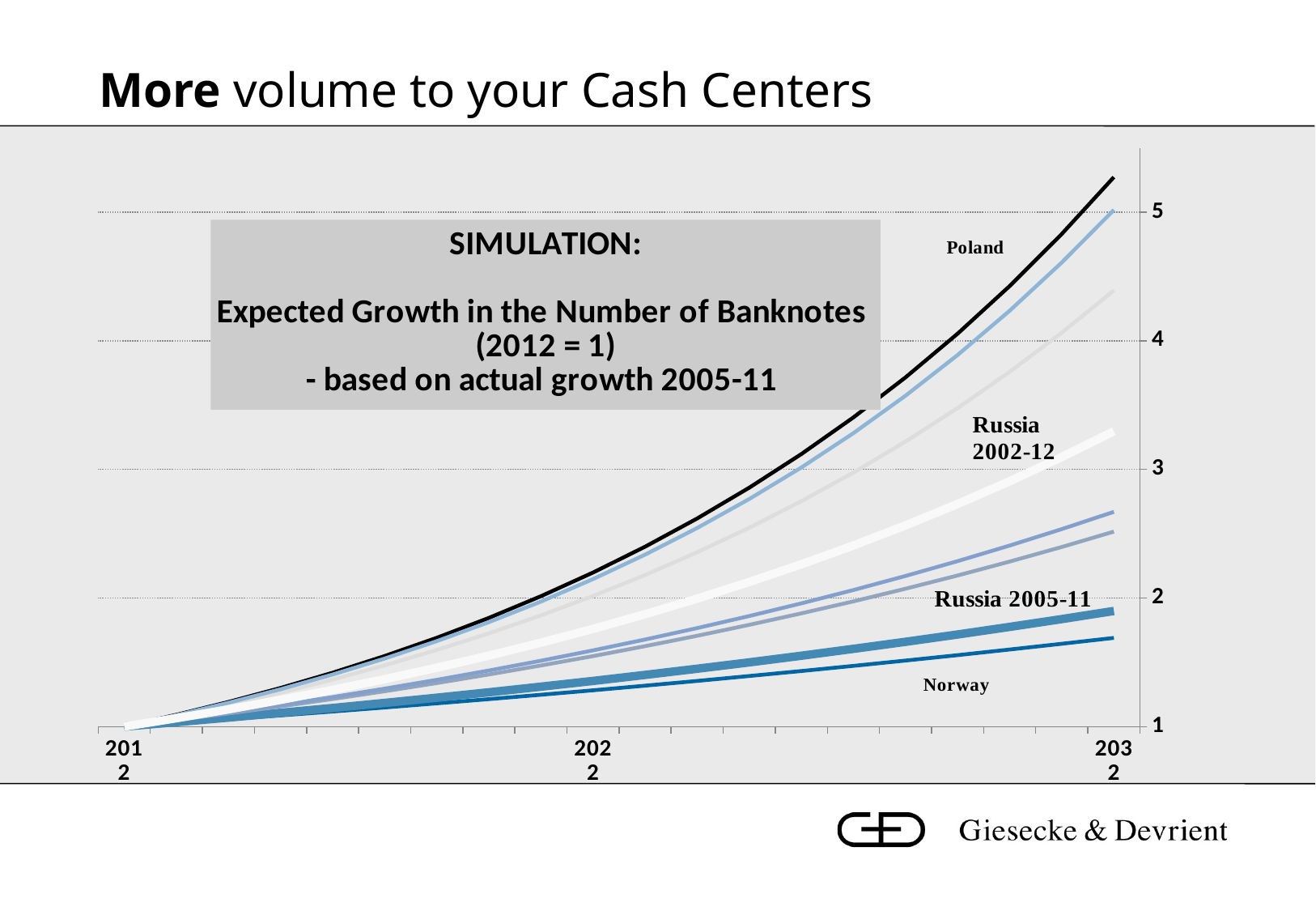
What is the highest value labeled on the y axis of the chart? 5 Do the lines on the chart rise or fall from 2012 to 2032? rise What years are labeled on the x axis of the chart? 2012, 2022, 2032 Which is larger at 2032, the value for Poland or the value for Norway? Poland Which labeled country has the highest line at 2032? Poland Which labeled country has the lowest line at 2032? Norway Is the value for Russia 2005-11 at 2032 greater or less than 2? less Is the value for Norway at 2032 greater or less than 2? less Which is larger at 2032, the value for Russia 2002-12 or the value for Russia 2005-11? Russia 2002-12 What kind of chart is shown on the slide? line chart Is the value for Russia 2002-12 at 2032 greater or less than 3? greater What is the index value of all lines in 2012, according to the chart title? 1